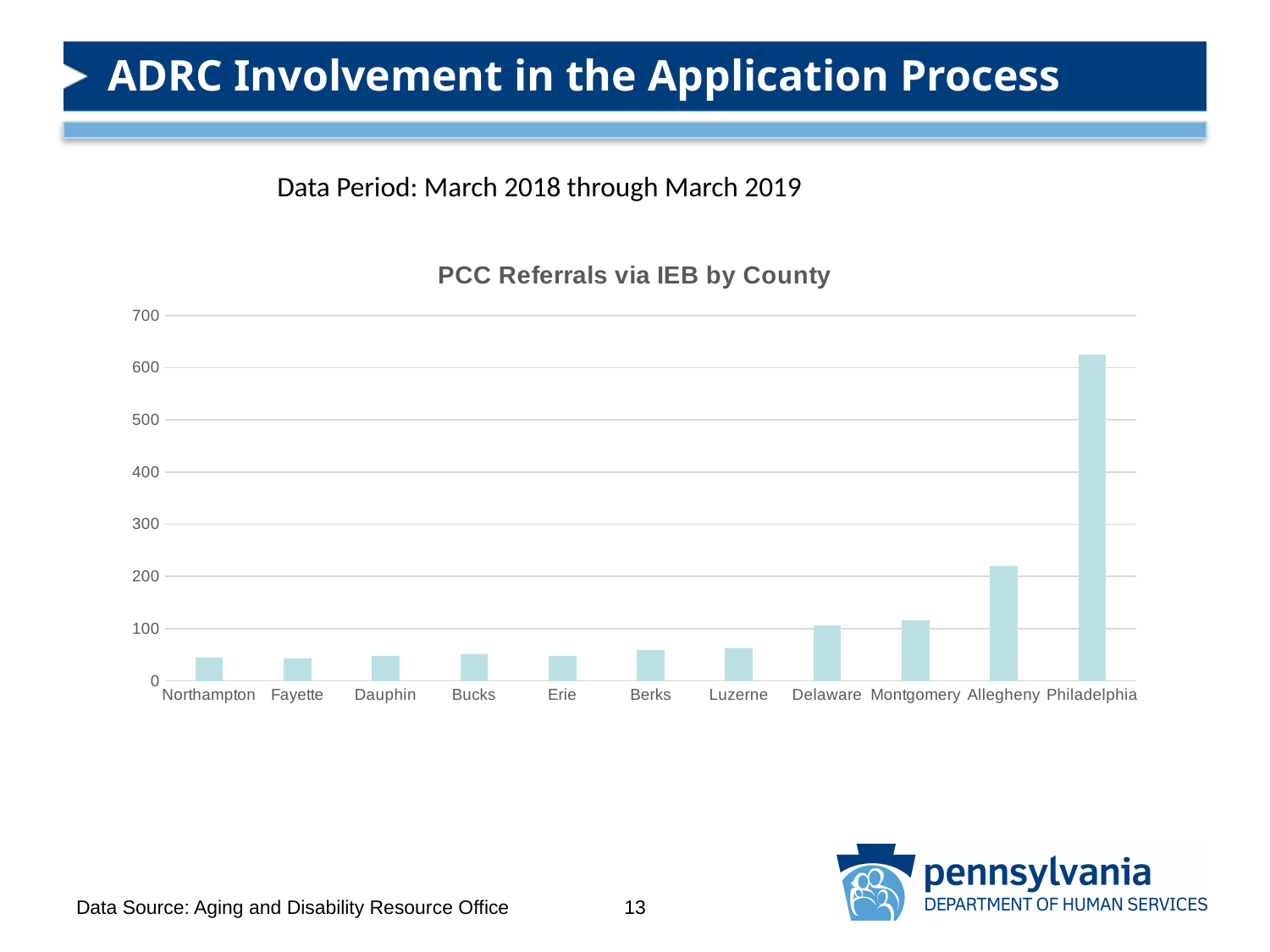
Is the value for Allegheny greater or less than 200? greater Is the value for Luzerne greater or less than 100? less Is the value for Northampton greater or less than 100? less What type of chart is shown on the slide? Bar chart Which has more PCC referrals via IEB, Delaware or Berks? Delaware Do the values generally rise or fall moving from left to right along the x axis? Rise How many counties are shown on the x axis of the chart? 11 Which county has the highest number of PCC referrals via IEB? Philadelphia Which has more PCC referrals via IEB, Allegheny or Montgomery? Allegheny What is the title of the chart? PCC Referrals via IEB by County What data period does the slide state the chart covers? March 2018 through March 2019